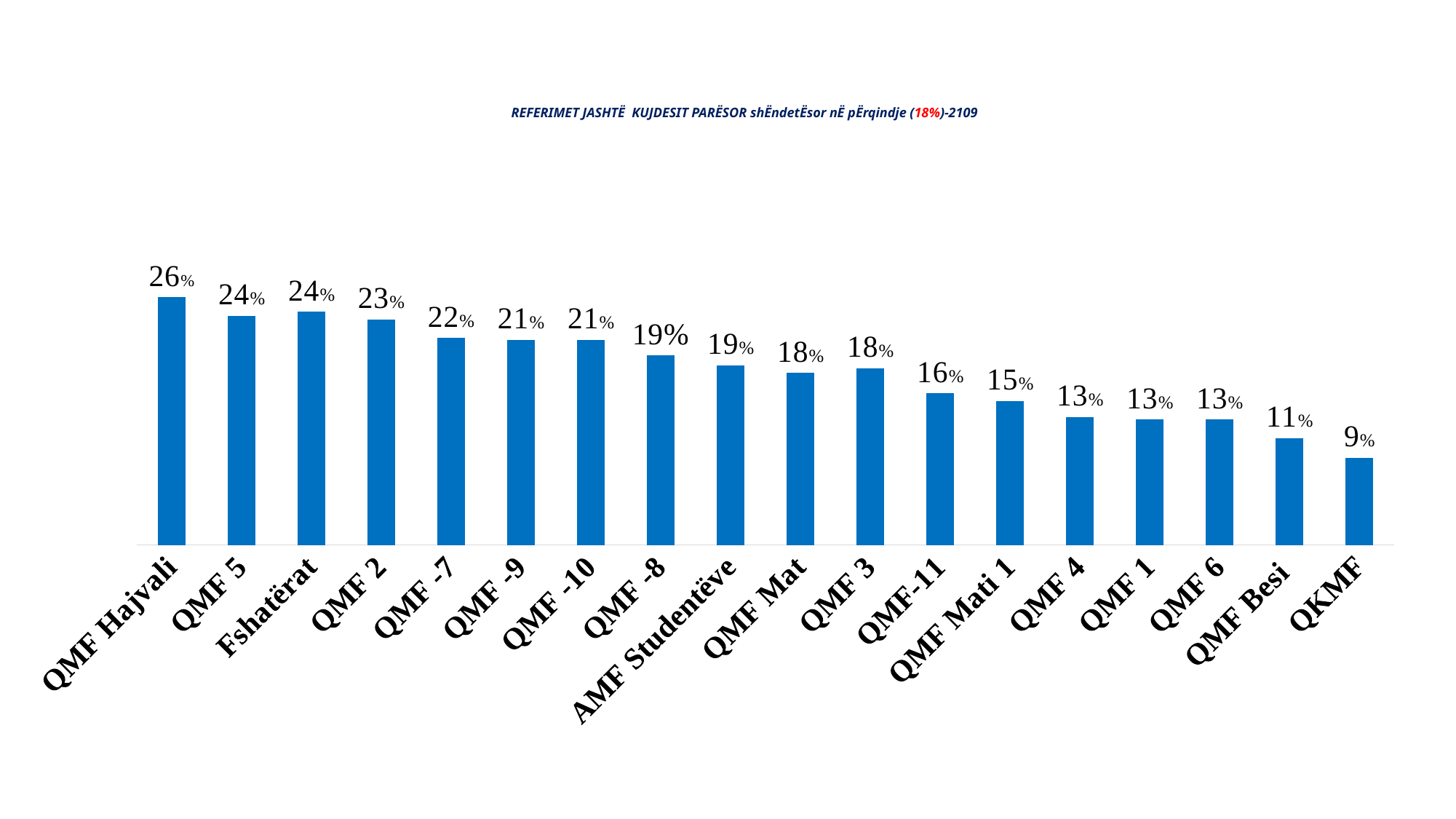
What kind of chart is shown on the slide? Bar chart What is the value for QMF Mati 1? 15% What is the difference between the values for QMF 2 and QMF-11? 7% What is the value for AMF Studentëve? 19% What is the value for QMF Hajvali? 26% Which is larger, the value for QMF -7 or the value for QMF 4? QMF -7 Which category has the highest value? QMF Hajvali How many categories are shown in the chart? 18 Which category has the lowest value? QKMF Do the values rise or fall from left to right along the x axis? Fall What is the value for QMF Besi? 11% What is the difference between the values for QMF Hajvali and QKMF? 17%